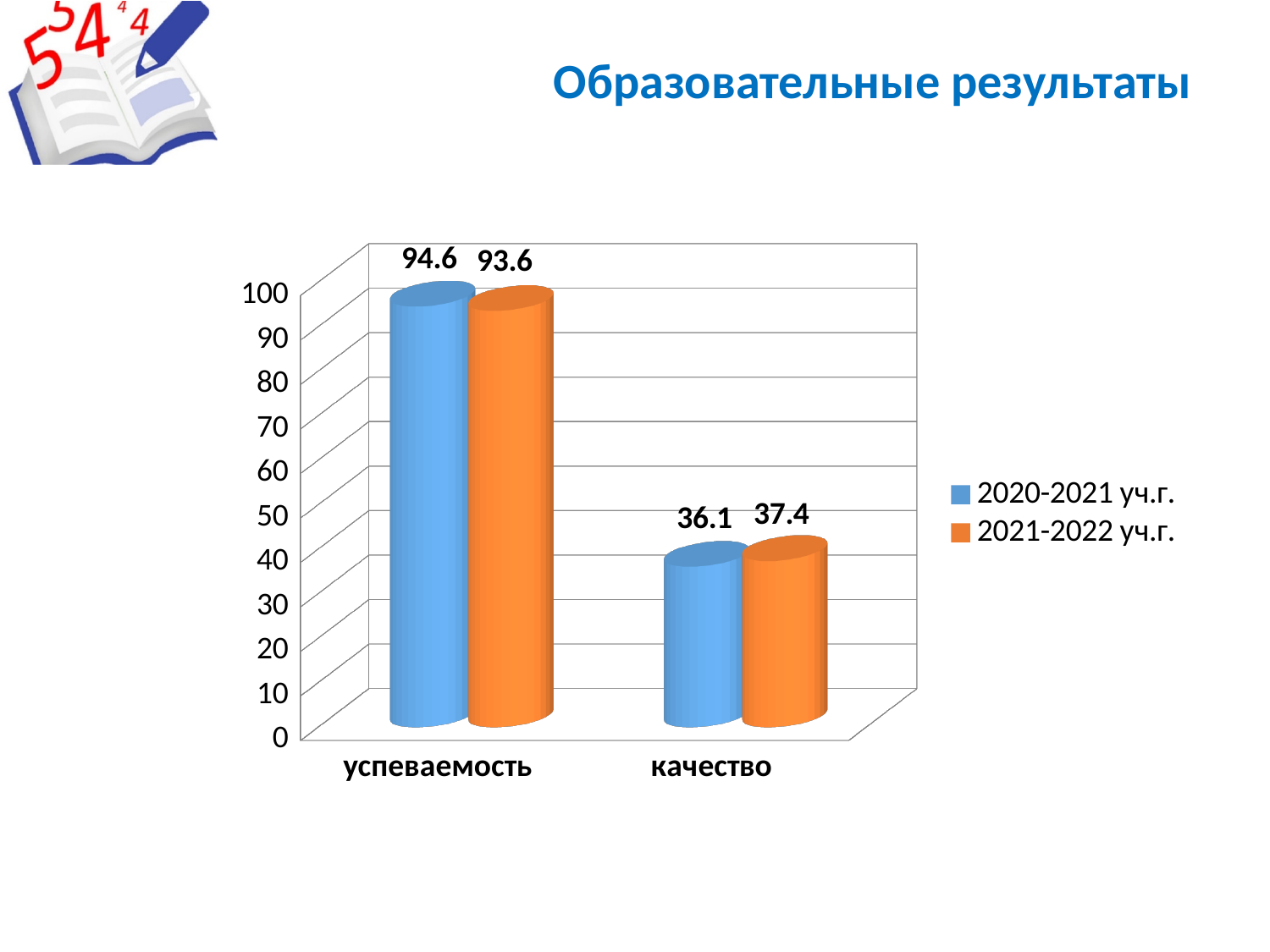
How many series does the legend list? 2 Which category has the lowest value in the 2020-2021 уч.г. series? качество Which is larger for качество: the 2020-2021 уч.г. value or the 2021-2022 уч.г. value? 2021-2022 уч.г. What is the value for успеваемость in 2020-2021 уч.г.? 94.6 What is the difference between the 2021-2022 уч.г. and 2020-2021 уч.г. values for качество? 1.3 What is the value for качество in 2021-2022 уч.г.? 37.4 What is the difference between the 2020-2021 уч.г. and 2021-2022 уч.г. values for успеваемость? 1.0 Which category has the highest value in the 2021-2022 уч.г. series? успеваемость What kind of chart is shown on the slide? bar chart What is the value for качество in 2020-2021 уч.г.? 36.1 How many categories are shown on the x axis? 2 What is the value for успеваемость in 2021-2022 уч.г.? 93.6